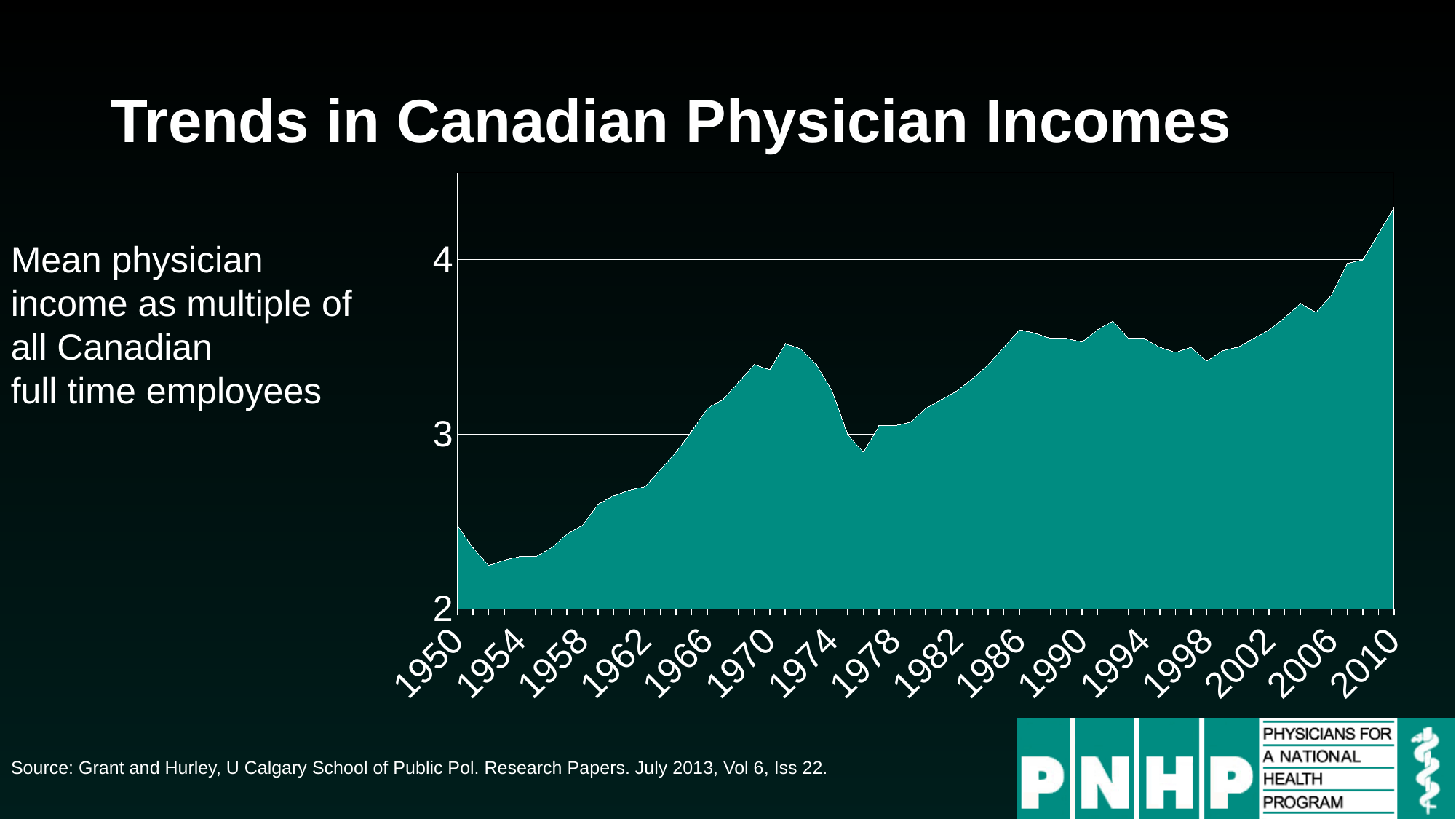
Is the value for 2010 greater or less than 4? greater What does the chart measure, according to the text on the left of the slide? Mean physician income as multiple of all Canadian full time employees Is the value for 1986 greater or less than 4? less Is the value for 1970 greater or less than 3? greater How many year labels are shown on the x axis? 16 Do the values rise or fall between 1998 and 2010? rise What kind of chart is shown on the slide? area chart Do the values rise or fall between 1970 and 1976? fall What is the title of the slide containing the chart? Trends in Canadian Physician Incomes